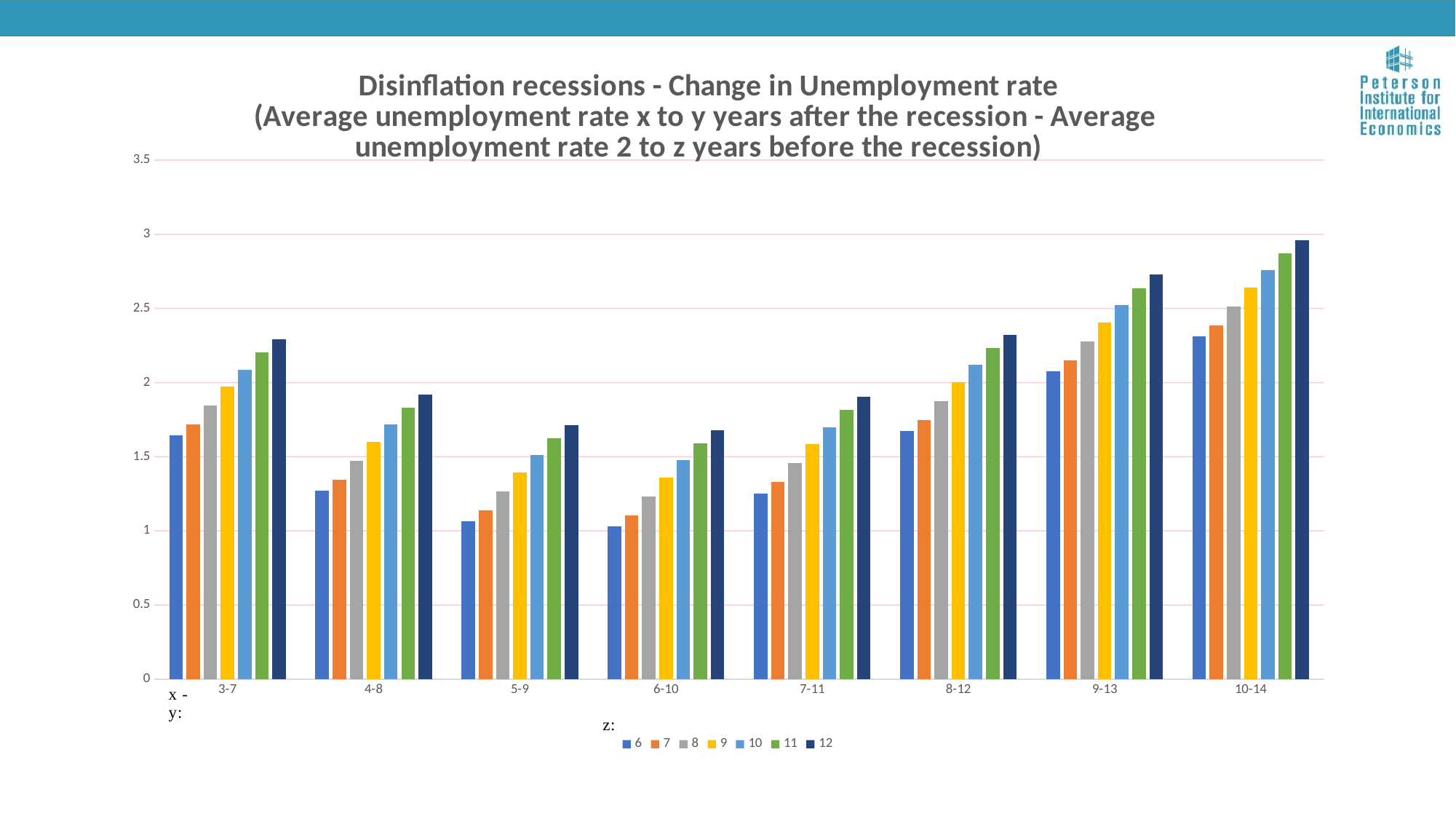
Which is larger: the z = 6 value for 3-7 or the z = 6 value for 4-8? 3-7 Is the value for z = 12 in the 7-11 category greater or less than 2? less How many x-y categories are shown on the x axis? 8 Which x-y category has the tallest bar for z = 12? 10-14 Is the value for z = 12 in the 9-13 category greater or less than 2.5? greater Within each x-y category, do the values rise or fall as z increases from 6 to 12? rise What kind of chart is shown on the slide? bar chart Is the value for z = 12 in the 3-7 category greater or less than 2? greater Within the 3-7 category, which z series has the lowest value? 6 Which x-y category has the lowest bar for z = 6? 6-10 Within the 10-14 category, which z series has the highest value? 12 How many series (z values) does the legend list? 7